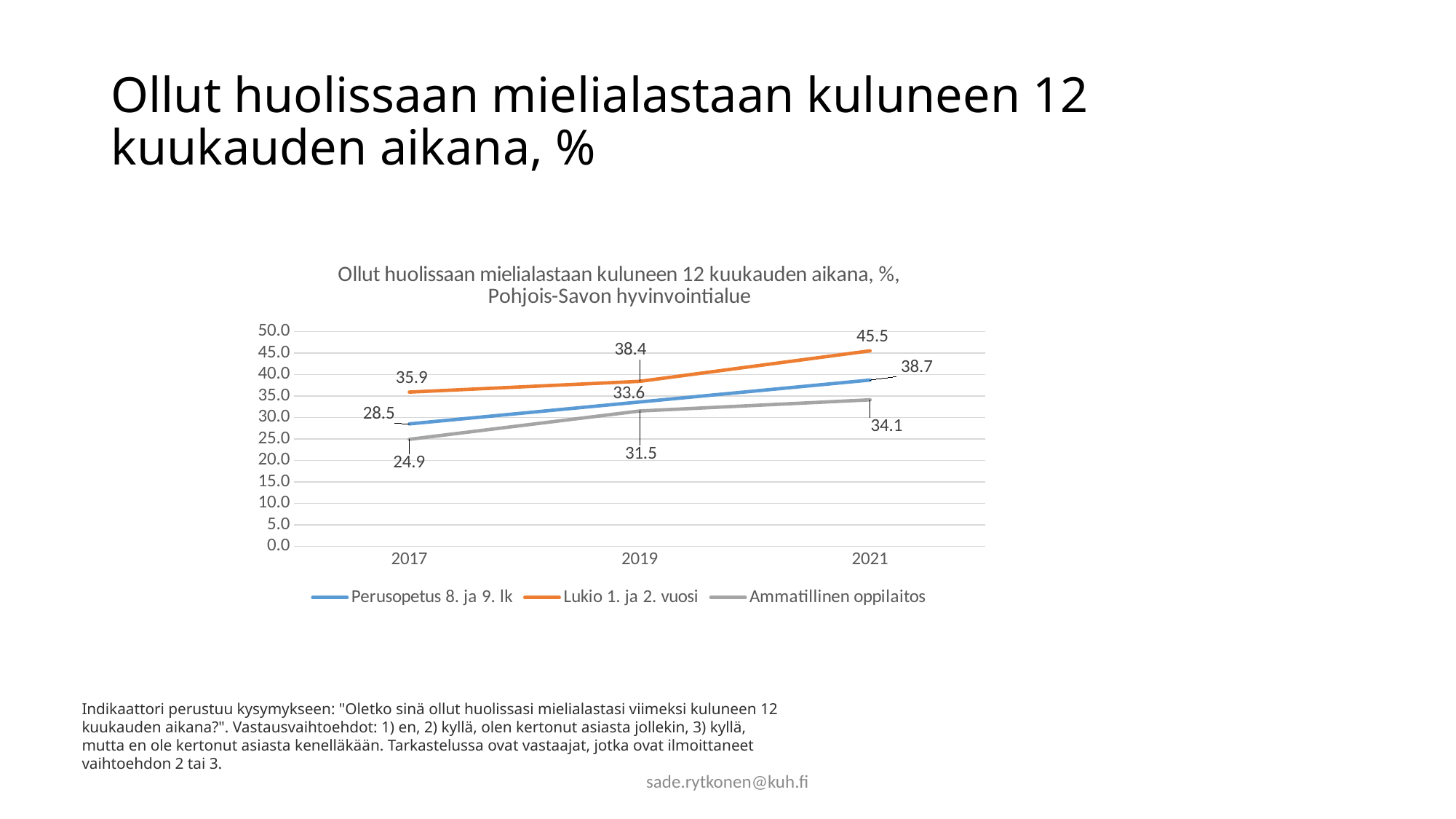
Do the values for Ammatillinen oppilaitos rise or fall from 2017 to 2021? Rise How many series does the legend list? 3 What is the difference between the Lukio 1. ja 2. vuosi values in 2021 and 2017? 9.6 Which series has the highest value in 2021? Lukio 1. ja 2. vuosi Which region is named in the chart title? Pohjois-Savon hyvinvointialue Which is larger in 2019: Perusopetus 8. ja 9. lk or Ammatillinen oppilaitos? Perusopetus 8. ja 9. lk How many years are shown on the x axis? 3 What is the value for Lukio 1. ja 2. vuosi in 2021? 45.5 What is the value for Perusopetus 8. ja 9. lk in 2017? 28.5 Which series has the lowest value in 2017? Ammatillinen oppilaitos What is the value for Ammatillinen oppilaitos in 2019? 31.5 What type of chart is shown on the slide? Line chart